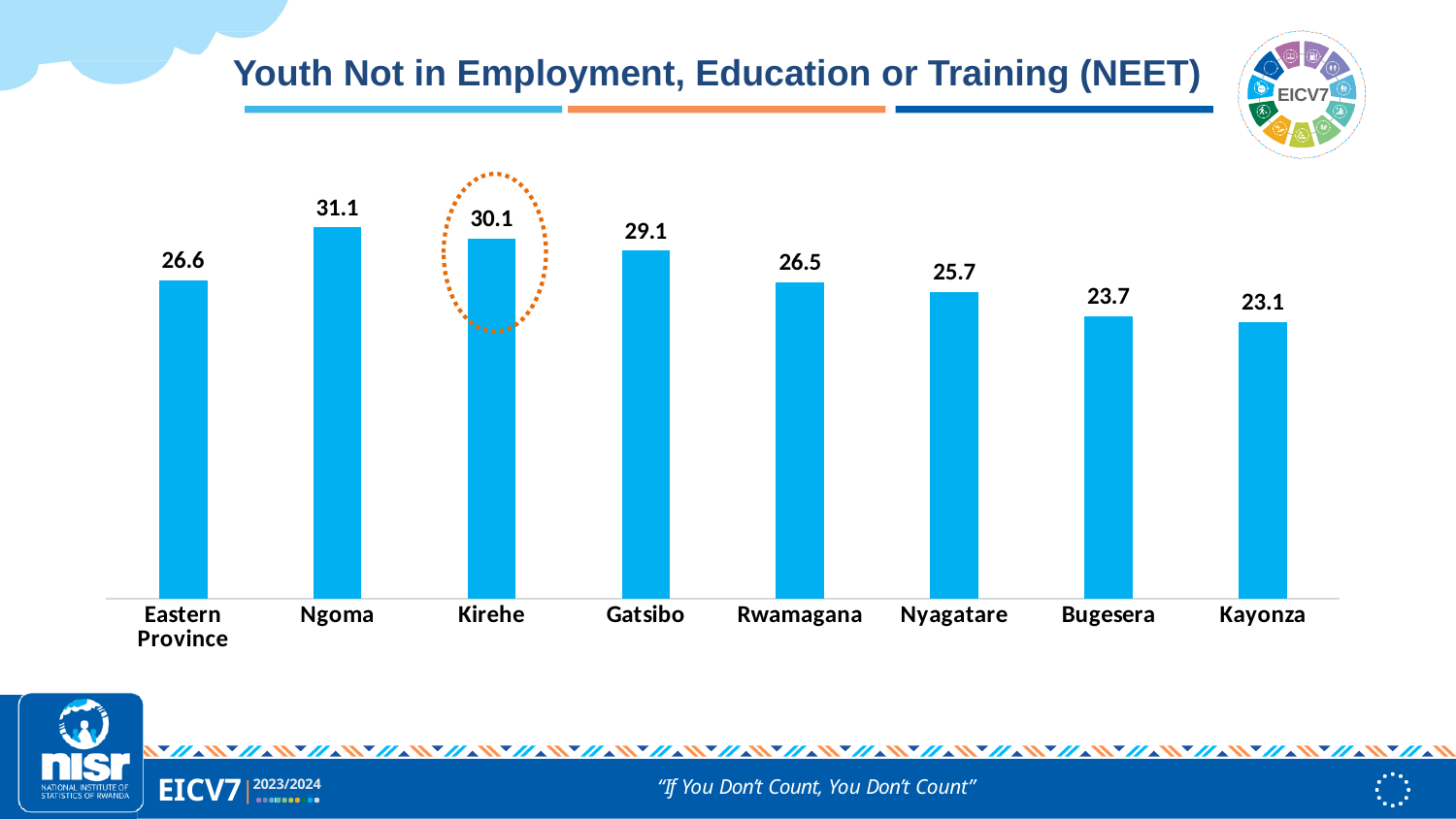
What is the difference between the NEET values for Gatsibo and Nyagatare? 3.4 Which category has the highest NEET value? Ngoma What is the NEET value for Eastern Province? 26.6 What is the difference between the NEET values for Ngoma and Kayonza? 8.0 What kind of chart is shown on the slide? Bar chart What is the NEET value for Kirehe? 30.1 What is the NEET value for Bugesera? 23.7 What is the NEET value for Ngoma? 31.1 Which has a higher NEET value, Kirehe or Rwamagana? Kirehe Which category has the lowest NEET value? Kayonza How many categories are shown on the chart? 8 Which category's bar is highlighted with a dotted orange circle? Kirehe